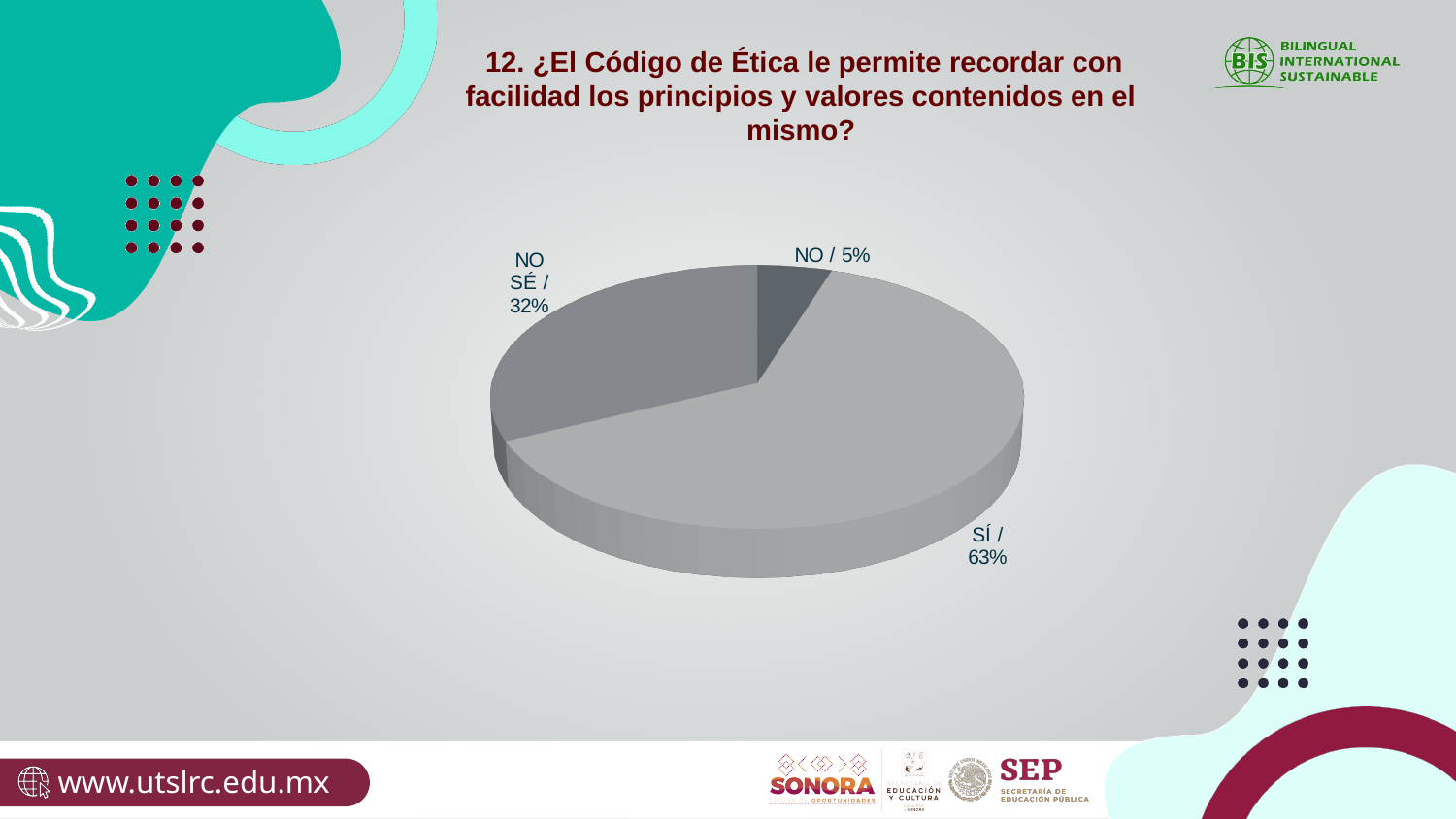
What is the difference in percentage points between SÍ and NO SÉ? 31 What question number is shown in the slide title? 12 What percentage of responses are NO SÉ? 32% What is the combined percentage of SÍ and NO responses? 68% What percentage of responses are SÍ? 63% Which response has the smallest share of the pie? NO What is the difference in percentage points between NO SÉ and NO? 27 How many slices does the pie chart have? 3 What kind of chart is shown on the slide? pie chart Which is larger, the share for NO SÉ or the share for NO? NO SÉ What percentage of responses are NO? 5% Which response has the largest share of the pie? SÍ